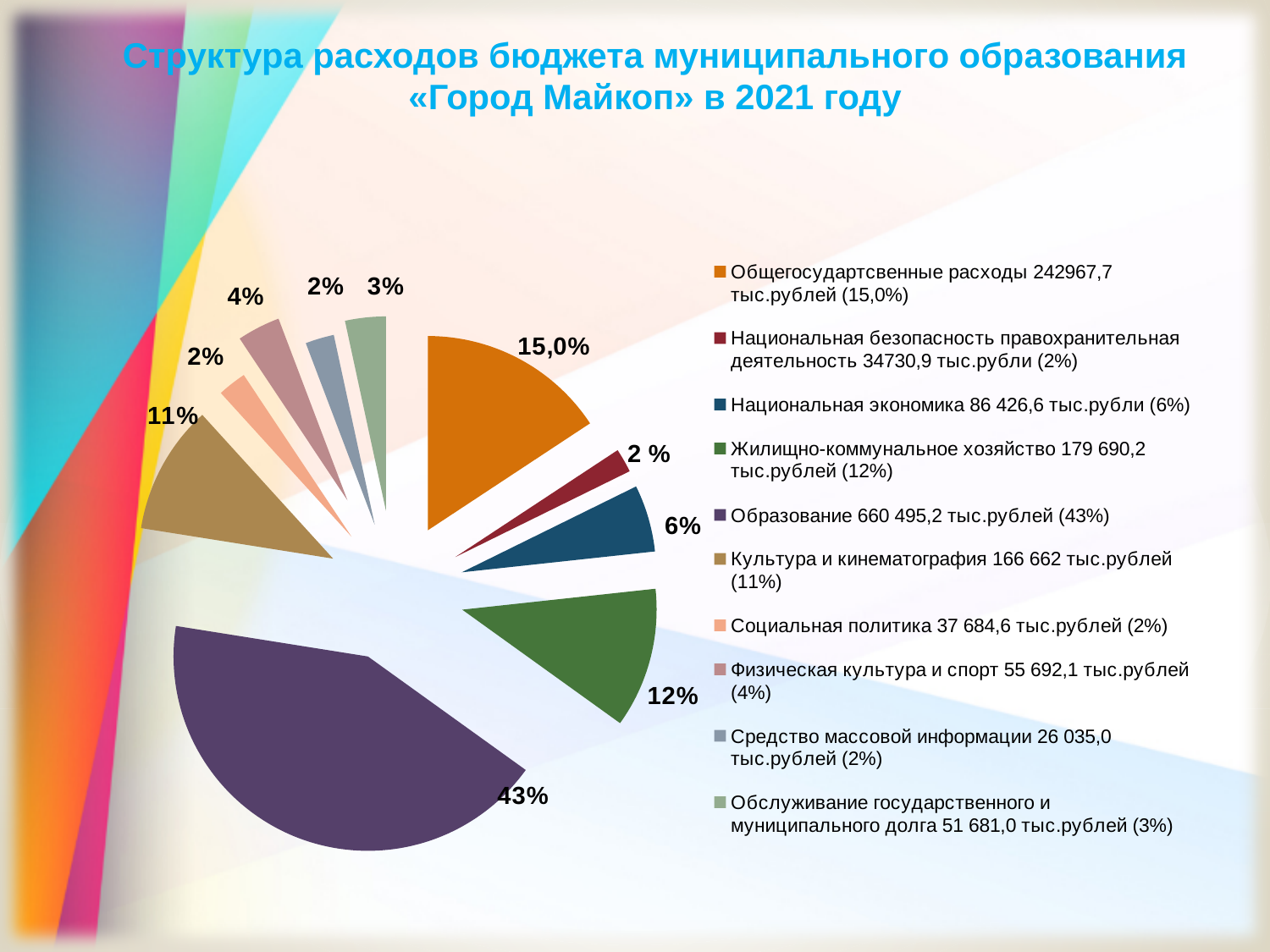
What share of the pie does Жилищно-коммунальное хозяйство take? 12% What share of the pie does Общегосударственные расходы take? 15,0% What share of the pie does Культура и кинематография take? 11% According to the legend, what is the amount for Образование? 660 495,2 тыс.рублей What is the title of the chart on the slide? Структура расходов бюджета муниципального образования «Город Майкоп» в 2021 году What is the difference in percentage points between the share for Образование and the share for Общегосударственные расходы? 28 percentage points How many slices does the pie chart have? 10 According to the legend, what is the amount for Национальная экономика? 86 426,6 тыс.рубли Which category has the largest slice of the pie? Образование What kind of chart is shown on the slide? pie chart Which is larger: the share for Физическая культура и спорт or the share for Обслуживание государственного и муниципального долга? Физическая культура и спорт